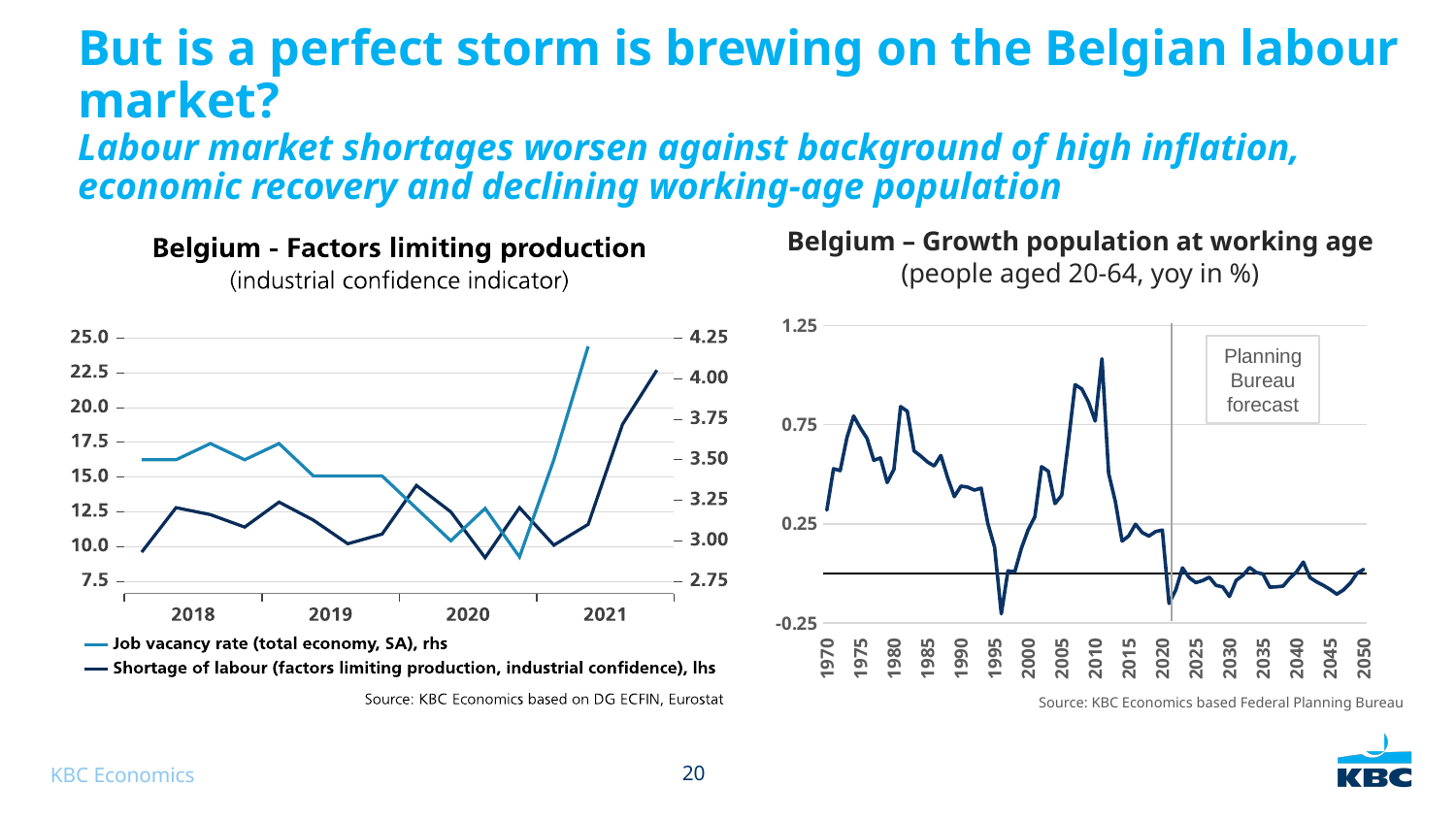
In the 'Belgium – Growth population at working age' chart, is the value at 2050 greater or less than 0.25? less In the 'Belgium - Factors limiting production' chart, does the Shortage of labour series rise or fall between the start of 2021 and its last point? rise In the 'Belgium - Factors limiting production' chart, is the last plotted value of the Shortage of labour series (late 2021) greater or less than 20.0 on the left axis? greater What kind of chart is the 'Belgium – Growth population at working age' chart on the right? line chart In the 'Belgium - Factors limiting production' chart, is the last plotted value of the Job vacancy rate series greater or less than 4.00 on the right axis? greater How many series does the legend of the 'Belgium - Factors limiting production' chart list? 2 In the 'Belgium - Factors limiting production' chart, which series is plotted on the right-hand axis (rhs)? Job vacancy rate (total economy, SA) What does the text box in the 'Belgium – Growth population at working age' chart label the period after the vertical line? Planning Bureau forecast What kind of chart is the 'Belgium - Factors limiting production' chart on the left? line chart In the 'Belgium – Growth population at working age' chart, do the values rise or fall between 2010 and 2020? fall